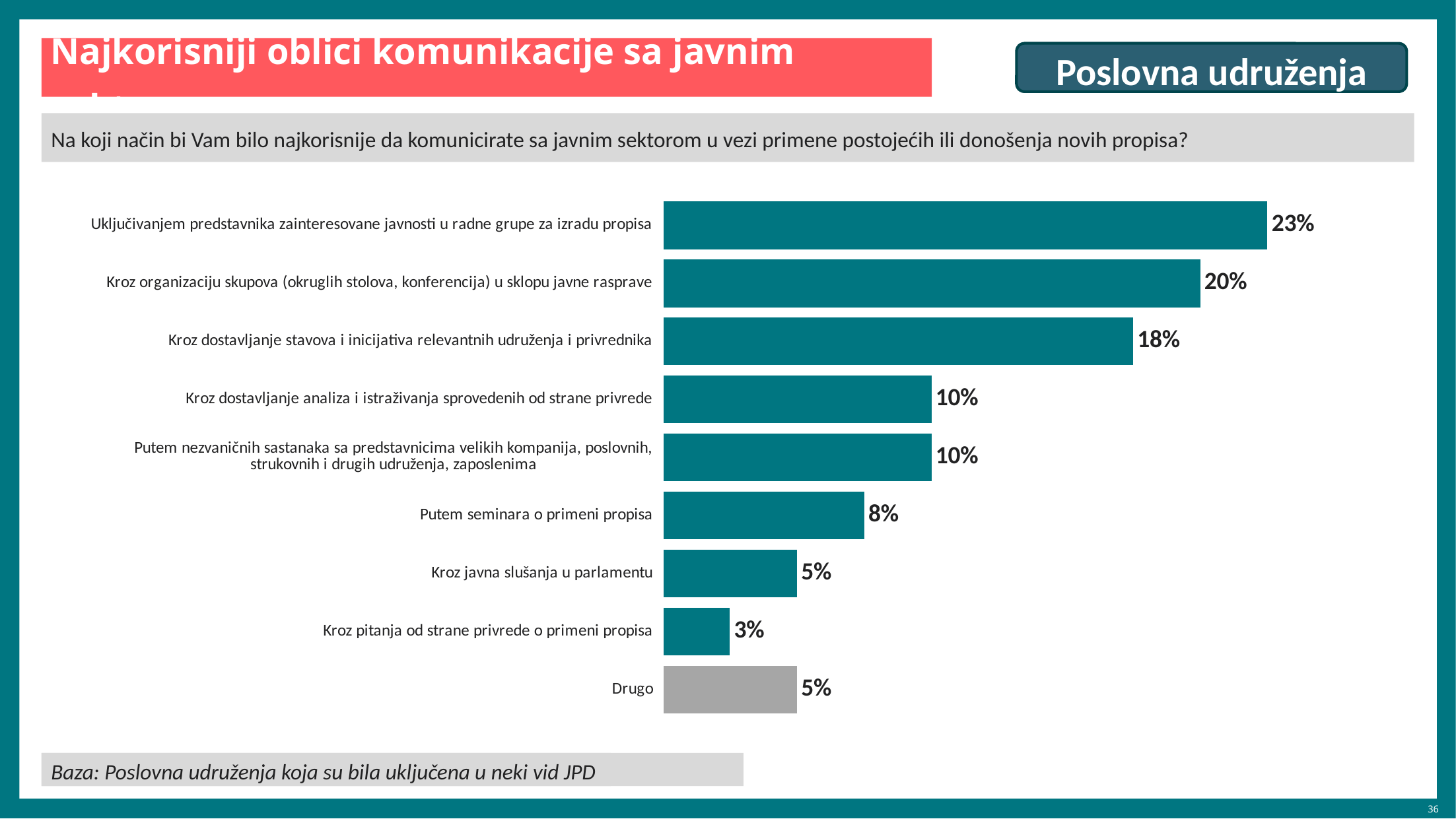
Which is larger: "Kroz javna slušanja u parlamentu" or "Putem seminara o primeni propisa"? Putem seminara o primeni propisa How many categories are shown in the chart? 9 What is the value for "Kroz pitanja od strane privrede o primeni propisa"? 3% What kind of chart is shown on the slide? Bar chart Which bar is shown in a different colour (grey) from the others? Drugo What is the value for "Uključivanjem predstavnika zainteresovane javnosti u radne grupe za izradu propisa"? 23% What is the value for "Drugo"? 5% What is the value for "Putem seminara o primeni propisa"? 8% Which category has the highest value? Uključivanjem predstavnika zainteresovane javnosti u radne grupe za izradu propisa Which category has the lowest value? Kroz pitanja od strane privrede o primeni propisa What is the difference between the highest value and the value for "Drugo"? 18% What is the difference between "Kroz organizaciju skupova (okruglih stolova, konferencija) u sklopu javne rasprave" and "Kroz dostavljanje stavova i inicijativa relevantnih udruženja i privrednika"? 2%